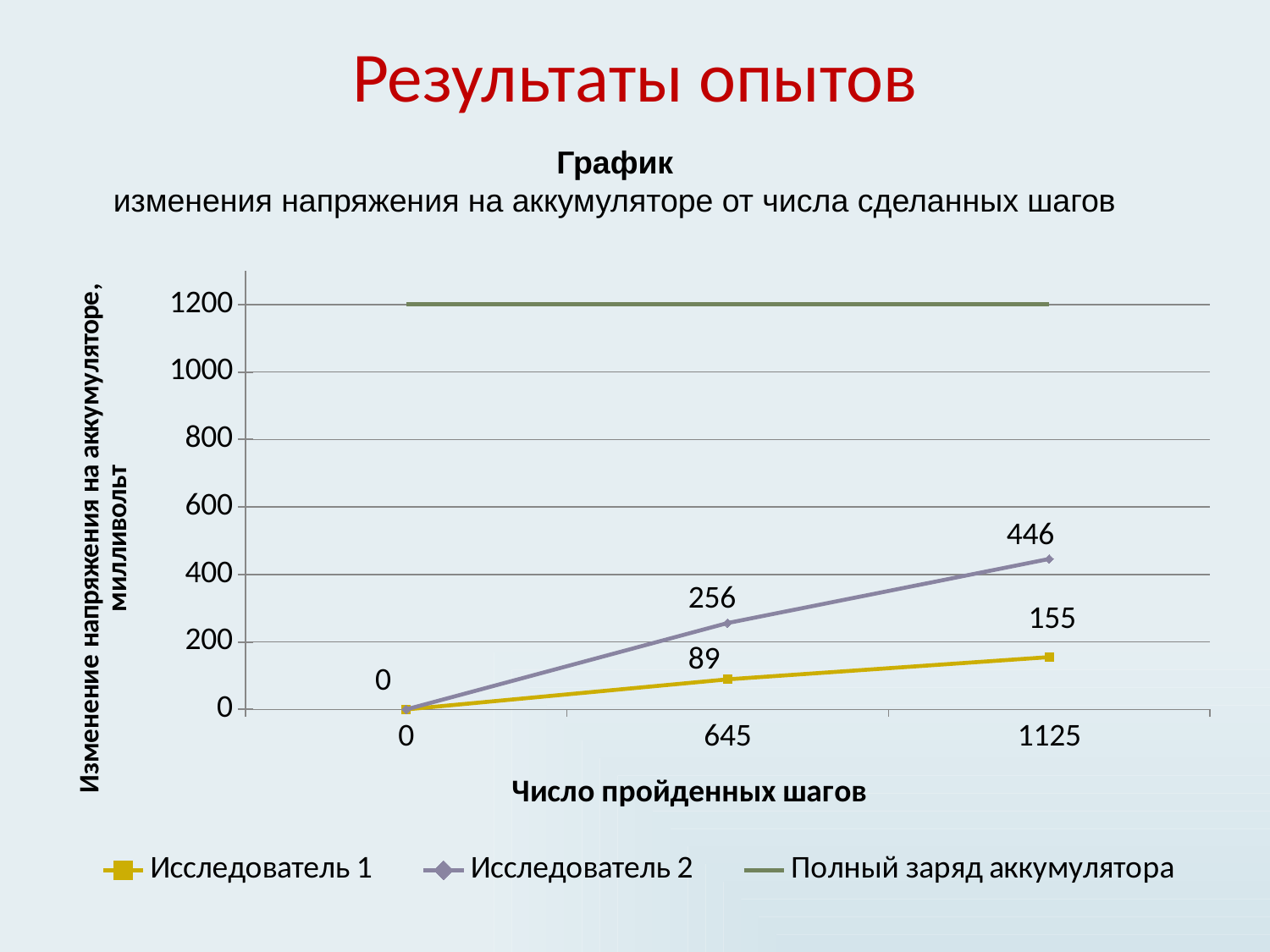
Do the values for Исследователь 2 rise or fall as the number of steps increases? rise Which series has the larger value at 645 steps, Исследователь 1 or Исследователь 2? Исследователь 2 What kind of chart is shown on the slide? line chart How many points are plotted on the x axis (number of steps)? 3 What is the value for Исследователь 2 at 645 steps? 256 What is the value for Исследователь 1 at 645 steps? 89 What is the label of the x axis? Число пройденных шагов What is the value for Исследователь 2 at 1125 steps? 446 What is the value for Исследователь 1 at 1125 steps? 155 At what level does the Полный заряд аккумулятора line sit? 1200 How many series does the legend list? 3 What is the difference between Исследователь 2 and Исследователь 1 at 1125 steps? 291